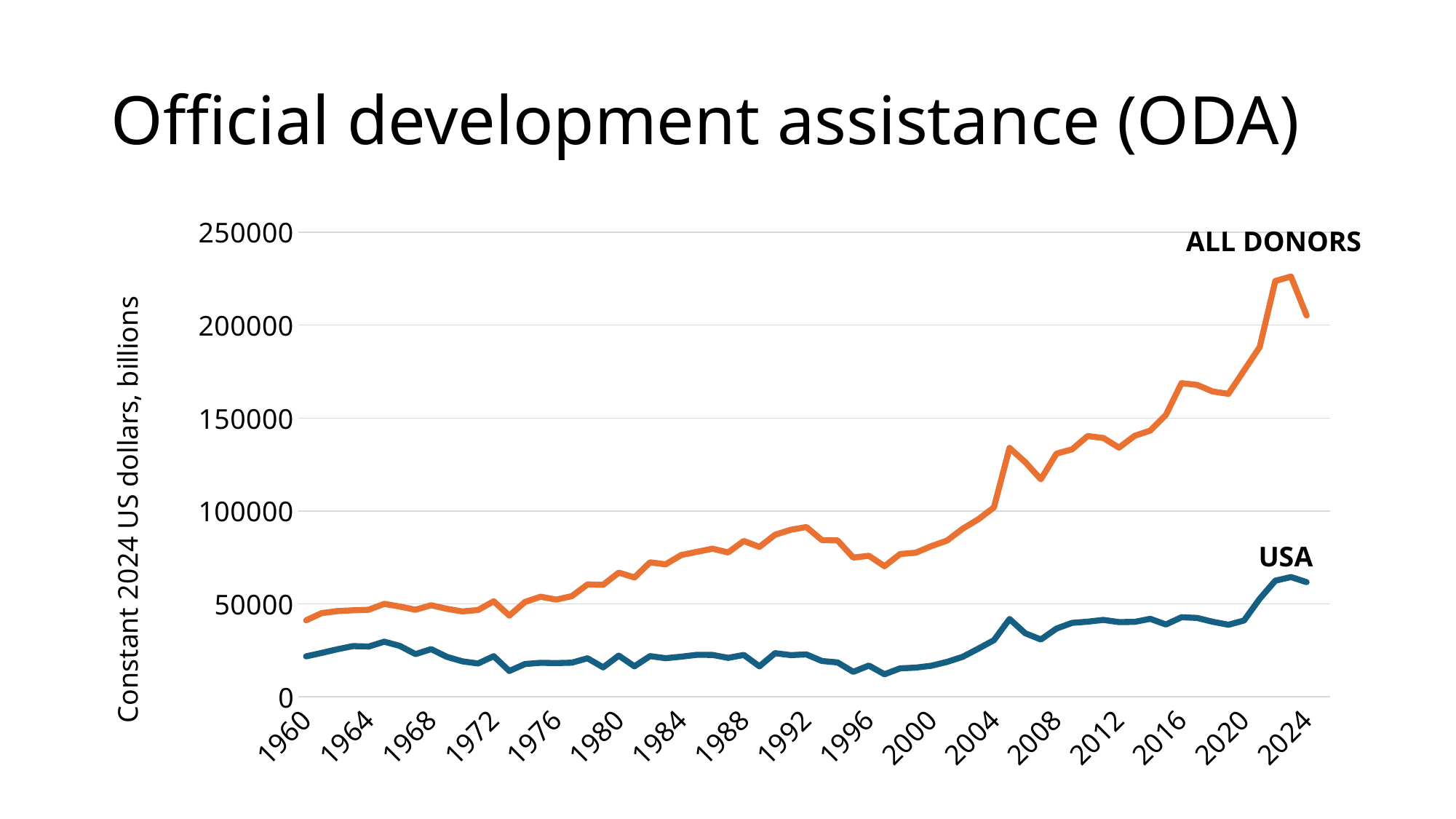
What is the label on the vertical axis? Constant 2024 US dollars, billions How many year labels are shown on the x axis? 17 Is the value for ALL DONORS in 2022 greater or less than 200000? greater Which series has the higher value in 2024, ALL DONORS or USA? ALL DONORS What is the title of the chart? Official development assistance (ODA) Is the value for ALL DONORS in 2008 greater or less than 100000? greater Is the value for USA in 2024 greater or less than 50000? greater How many series are plotted on the chart? 2 What kind of chart is shown on the slide? line chart Does the ALL DONORS series overall rise or fall from 1960 to 2024? rise